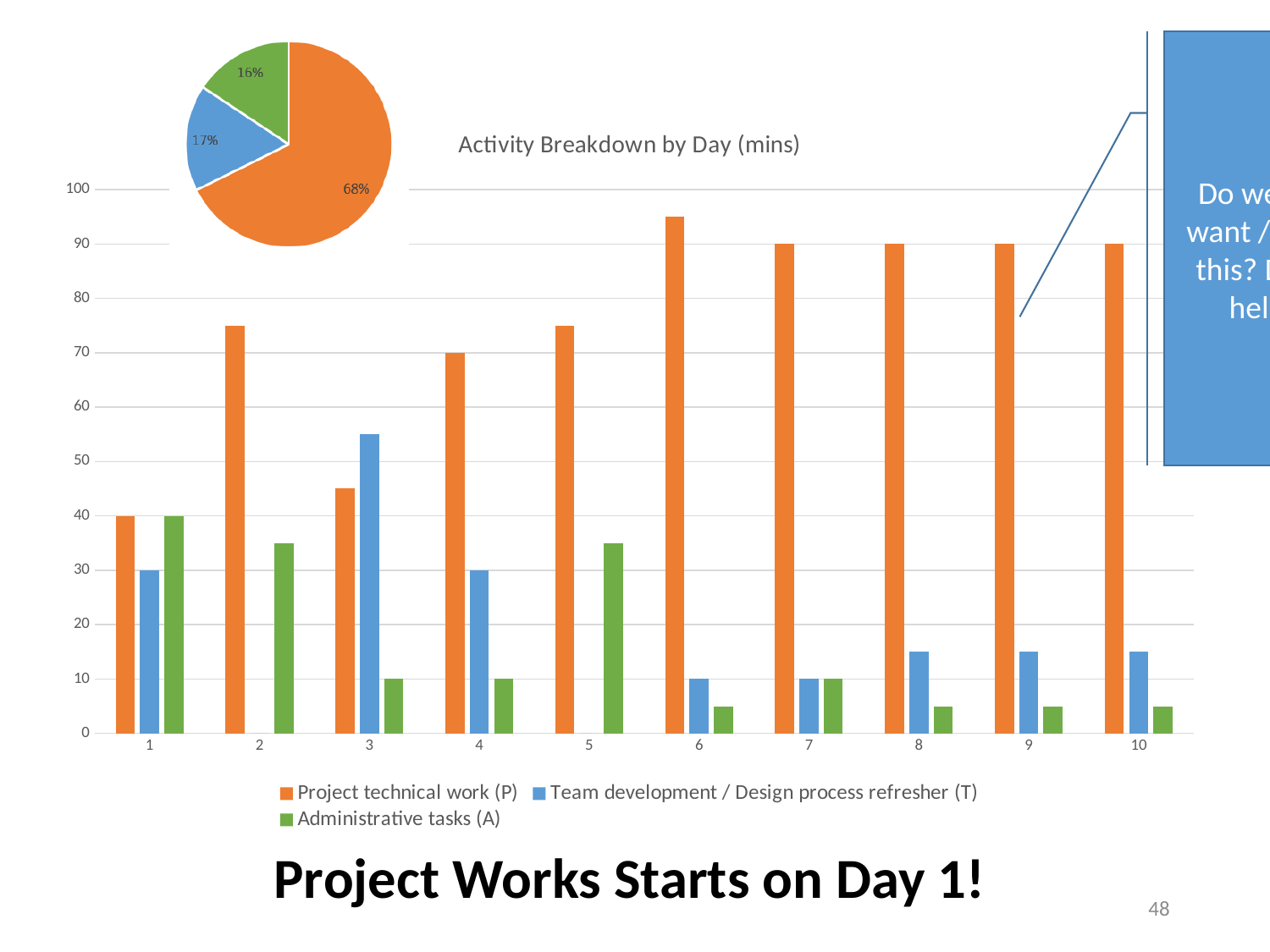
On the bar chart 'Activity Breakdown by Day (mins)', how many days are shown on the x axis? 10 On the bar chart 'Activity Breakdown by Day (mins)', how many series does the legend list? 3 On the bar chart 'Activity Breakdown by Day (mins)', is the value for Project technical work (P) on day 6 greater or less than 90? greater On the bar chart 'Activity Breakdown by Day (mins)', what is the value for Project technical work (P) on day 1? 40 On the bar chart 'Activity Breakdown by Day (mins)', what is the value for Team development / Design process refresher (T) on day 4? 30 On the bar chart 'Activity Breakdown by Day (mins)', what is the value for Administrative tasks (A) on day 7? 10 On the bar chart 'Activity Breakdown by Day (mins)', on which day is Project technical work (P) lowest? 1 On the pie chart at the top left of the slide, what share does the largest slice have? 68% On the bar chart 'Activity Breakdown by Day (mins)', is the value for Team development / Design process refresher (T) on day 3 greater or less than 50? greater On the bar chart 'Activity Breakdown by Day (mins)', which is larger on day 4: Project technical work (P) or Administrative tasks (A)? Project technical work (P) On the bar chart 'Activity Breakdown by Day (mins)', what is the value for Project technical work (P) on day 10? 90 On the bar chart 'Activity Breakdown by Day (mins)', on which day is Project technical work (P) highest? 6